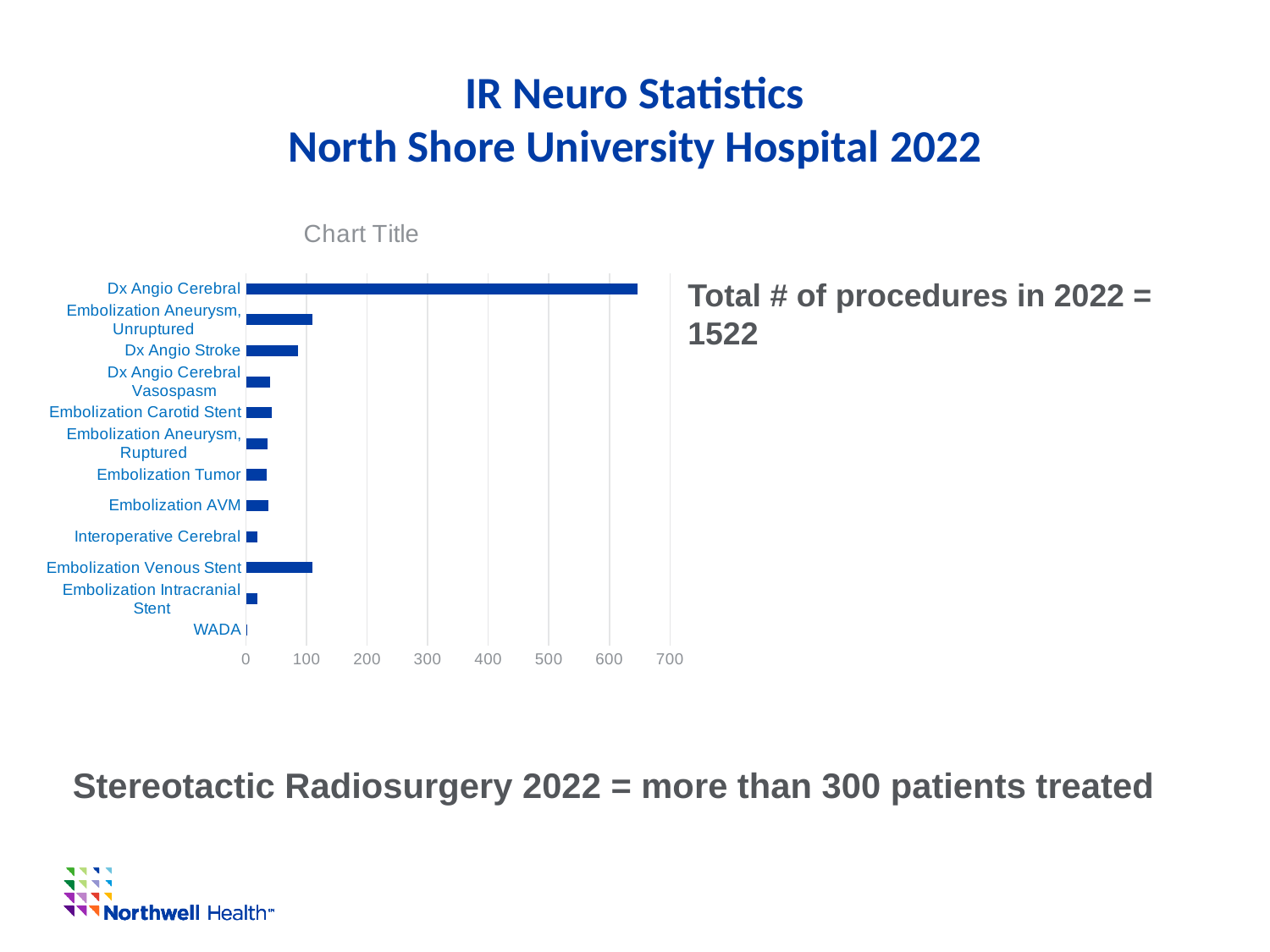
What is the title shown above the chart? Chart Title What kind of chart is shown on the slide? bar chart Which is larger, the value for Dx Angio Cerebral or the value for Dx Angio Stroke? Dx Angio Cerebral Which is larger, the value for Embolization Venous Stent or the value for Embolization Intracranial Stent? Embolization Venous Stent Which category has the lowest value in the chart? WADA What is the highest value shown on the chart's horizontal axis? 700 Is the value for Dx Angio Cerebral greater or less than 600? greater How many categories are plotted in the chart? 12 Is the value for Dx Angio Stroke greater or less than 100? less Is the value for Interoperative Cerebral greater or less than 100? less Which category has the highest value in the chart? Dx Angio Cerebral